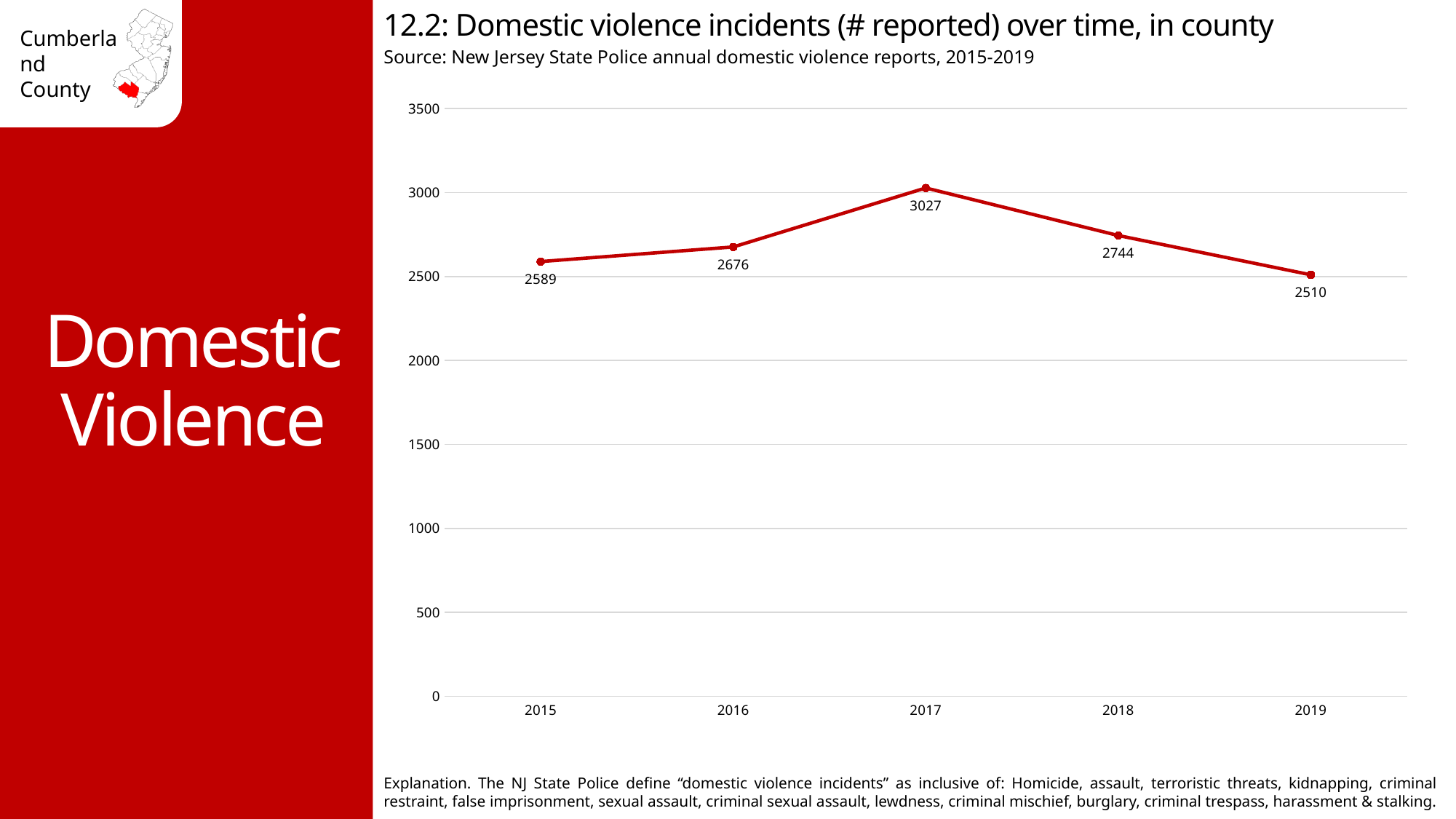
How many domestic violence incidents were reported in 2015? 2589 Which year had more reported incidents, 2016 or 2018? 2018 Which year had the lowest number of reported domestic violence incidents? 2019 What is the source of the data shown in the chart? New Jersey State Police annual domestic violence reports, 2015-2019 How many years are plotted on the chart? 5 Which year had the highest number of reported domestic violence incidents? 2017 How many domestic violence incidents were reported in 2017? 3027 How many domestic violence incidents were reported in 2019? 2510 What type of chart is shown on the slide? line chart What is the difference between the number of incidents in 2016 and 2015? 87 What is the difference between the number of incidents in 2017 and 2019? 517 Did the number of reported incidents rise or fall from 2017 to 2019? fall